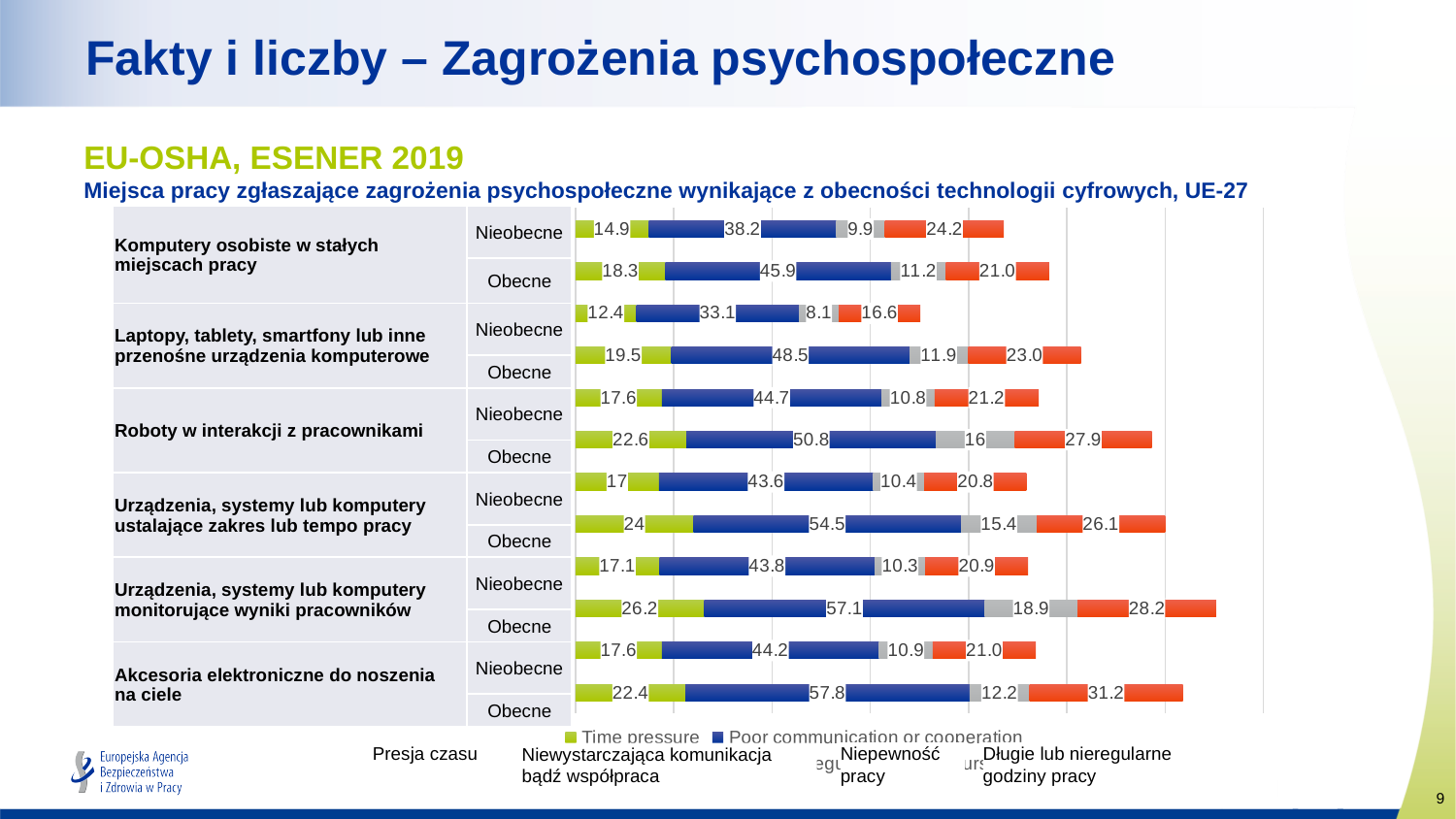
What is the total of the stacked bar for 'Laptopy, tablety, smartfony lub inne przenośne urządzenia komputerowe', Nieobecne? 70.2 How many bars are plotted in the chart? 12 What is the value of Presja czasu for 'Komputery osobiste w stałych miejscach pracy', Obecne? 18.3 What is the difference in Niewystarczająca komunikacja bądź współpraca between Obecne and Nieobecne for 'Urządzenia, systemy lub komputery ustalające zakres lub tempo pracy'? 10.9 What kind of chart is shown on the slide? Stacked bar chart How many series does the legend list? 4 Which bar has the lowest value for Niewystarczająca komunikacja bądź współpraca? Laptopy, tablety, smartfony lub inne przenośne urządzenia komputerowe, Nieobecne What is the value of Niewystarczająca komunikacja bądź współpraca for 'Roboty w interakcji z pracownikami', Obecne? 50.8 What is the value of Długie lub nieregularne godziny pracy for 'Akcesoria elektroniczne do noszenia na ciele', Obecne? 31.2 What is the value of Niepewność pracy for 'Laptopy, tablety, smartfony lub inne przenośne urządzenia komputerowe', Nieobecne? 8.1 Which bar has the highest value for Presja czasu? Urządzenia, systemy lub komputery monitorujące wyniki pracowników, Obecne Which is larger: Długie lub nieregularne godziny pracy for 'Komputery osobiste w stałych miejscach pracy' Nieobecne or Obecne? Nieobecne